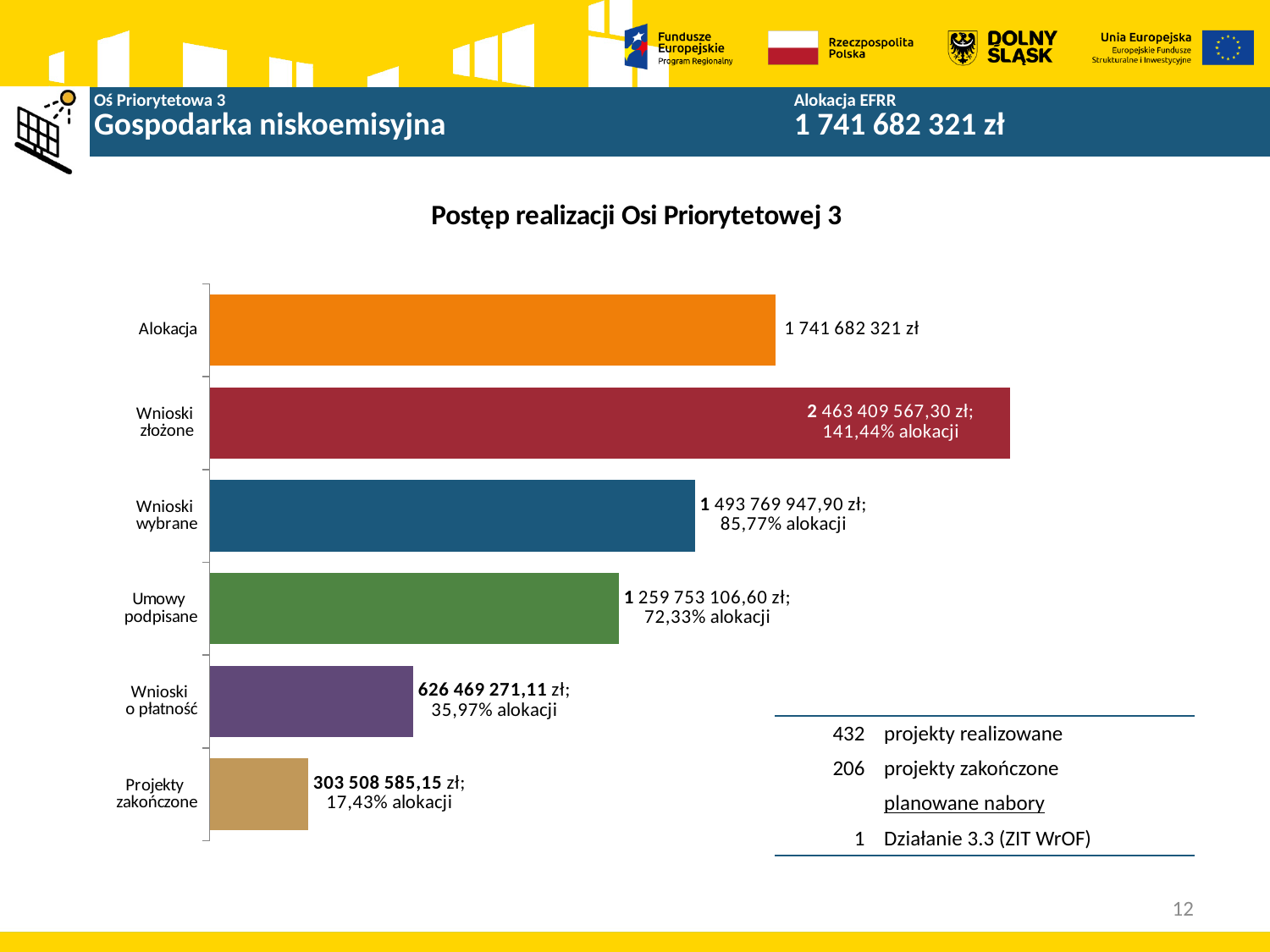
Which is larger, Wnioski wybrane or Umowy podpisane? Wnioski wybrane What kind of chart is shown on the slide? Bar chart What is the title of the chart? Postęp realizacji Osi Priorytetowej 3 What is the value shown for Wnioski złożone? 2 463 409 567,30 zł What percentage of the allocation do Umowy podpisane represent? 72,33% alokacji How many categories (bars) does the chart show? 6 Which category has the highest value? Wnioski złożone What is the value shown for Wnioski o płatność? 626 469 271,11 zł What percentage of the allocation do Projekty zakończone represent? 17,43% alokacji What is the value shown for Alokacja? 1 741 682 321 zł What colour is the bar for Wnioski złożone? Dark red Which category has the lowest value? Projekty zakończone